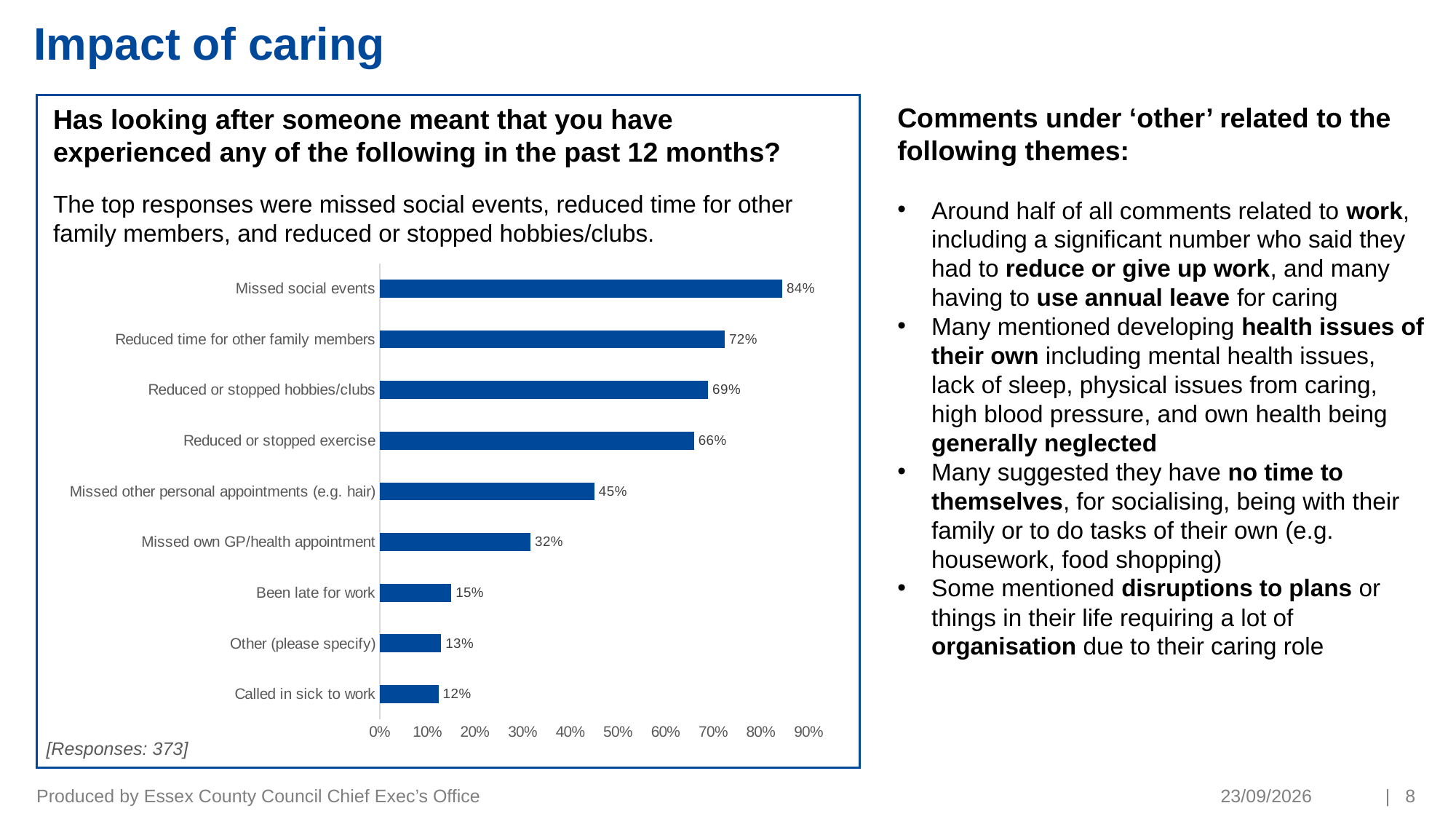
Which is larger: 'Other (please specify)' or 'Called in sick to work'? Other (please specify) What is the difference between 'Reduced time for other family members' and 'Reduced or stopped hobbies/clubs'? 3% What percentage of respondents reported missed social events? 84% How many responses does the chart note say it is based on? 373 How many categories are shown in the chart? 9 Is the value for 'Missed own GP/health appointment' greater or less than 40%? less What is the difference between 'Missed other personal appointments (e.g. hair)' and 'Missed own GP/health appointment'? 13% What percentage of respondents said they had been late for work? 15% What is the value for 'Reduced or stopped exercise'? 66% What kind of chart is shown on the slide? Bar chart Which category has the lowest value in the chart? Called in sick to work Which category has the highest value in the chart? Missed social events